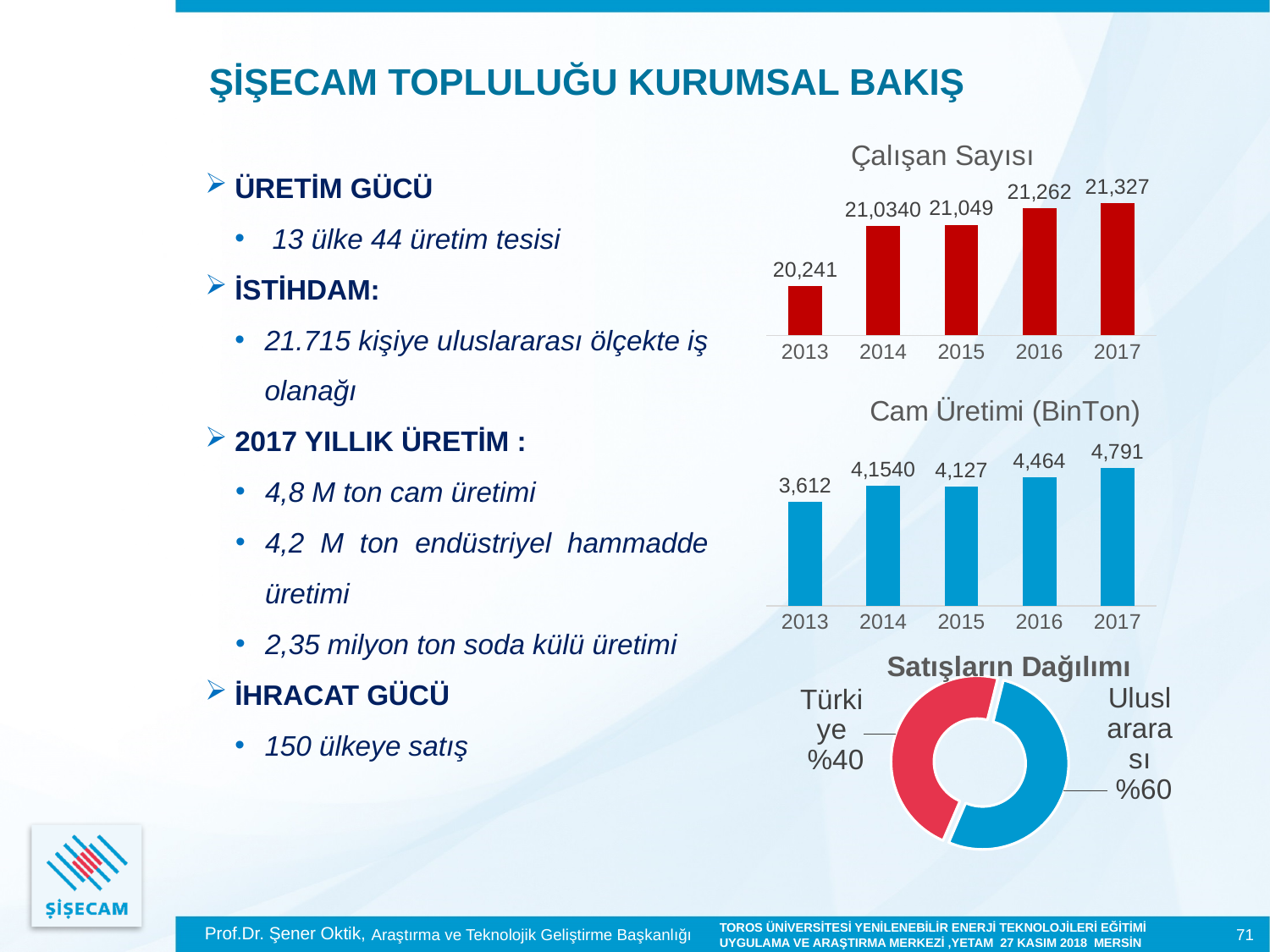
In the 'Satışların Dağılımı' chart, what share is 'Uluslararası'? %60 How many years are shown on the x axis of the 'Cam Üretimi (BinTon)' chart? 5 In the 'Çalışan Sayısı' chart, which year has the highest value? 2017 In the 'Çalışan Sayısı' chart, what is the value for 2013? 20,241 In the 'Cam Üretimi (BinTon)' chart, what is the value for 2016? 4,464 In the 'Cam Üretimi (BinTon)' chart, what is the difference between the 2017 and 2013 values? 1,179 What kind of chart is the 'Çalışan Sayısı' chart? Bar chart In the 'Cam Üretimi (BinTon)' chart, which is larger, the value for 2015 or 2016? 2016 In the 'Çalışan Sayısı' chart, what is the value for 2017? 21,327 In the 'Cam Üretimi (BinTon)' chart, what is the value for 2017? 4,791 In the 'Çalışan Sayısı' chart, what is the difference between the 2017 and 2013 values? 1,086 In the 'Çalışan Sayısı' chart, which year has the lowest value? 2013